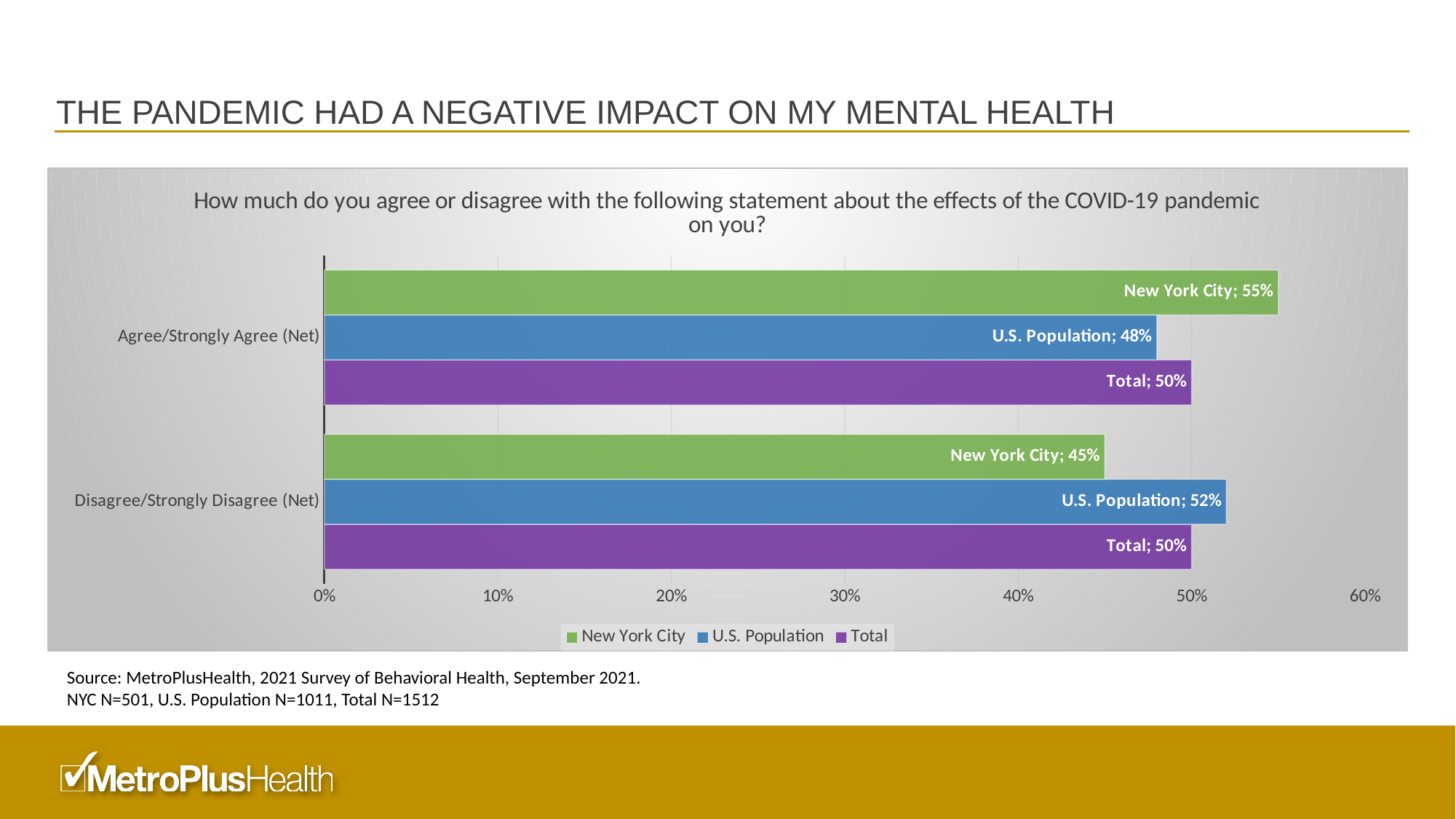
How many series does the legend list? 3 Which series has the highest value in the Agree/Strongly Agree (Net) category? New York City What is the value for New York City in the Agree/Strongly Agree (Net) category? 55% What is the difference between the New York City and U.S. Population values for Agree/Strongly Agree (Net)? 7% Which is larger: the New York City value for Agree/Strongly Agree (Net) or the New York City value for Disagree/Strongly Disagree (Net)? Agree/Strongly Agree (Net) How many categories are shown on the vertical axis? 2 Is the U.S. Population value for Agree/Strongly Agree (Net) greater or less than 50%? less What is the value for U.S. Population in the Disagree/Strongly Disagree (Net) category? 52% Which series has the lowest value in the Disagree/Strongly Disagree (Net) category? New York City What is the difference between the U.S. Population and New York City values for Disagree/Strongly Disagree (Net)? 7% What kind of chart is shown on the slide? Bar chart What is the Total value for Agree/Strongly Agree (Net)? 50%